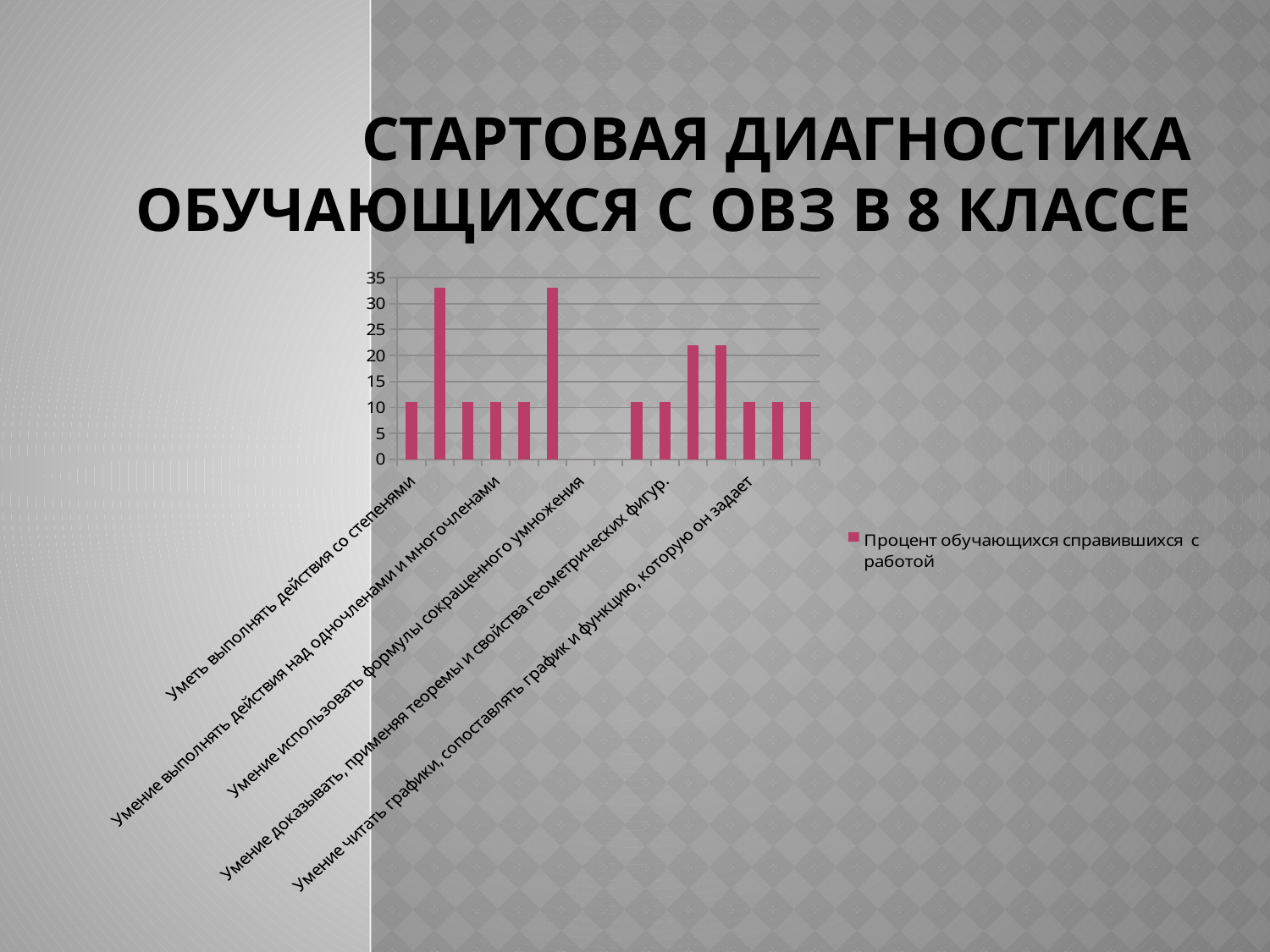
Is the value of the second bar from the left greater or less than 30? greater Is the value of the rightmost bar greater or less than 20? less What kind of chart is shown on the slide? bar chart Is the value of the first bar from the left greater or less than 15? less How many bars in the chart rise above the 30 gridline? 2 Which is larger, the first bar from the left or the second bar from the left? the second bar What is the highest value shown on the vertical axis? 35 What is the legend entry of the series shown in the chart? Процент обучающихся справившихся с работой How many series does the chart legend list? 1 What is the title of the slide containing the chart? СТАРТОВАЯ ДИАГНОСТИКА ОБУЧАЮЩИХСЯ С ОВЗ В 8 КЛАССЕ